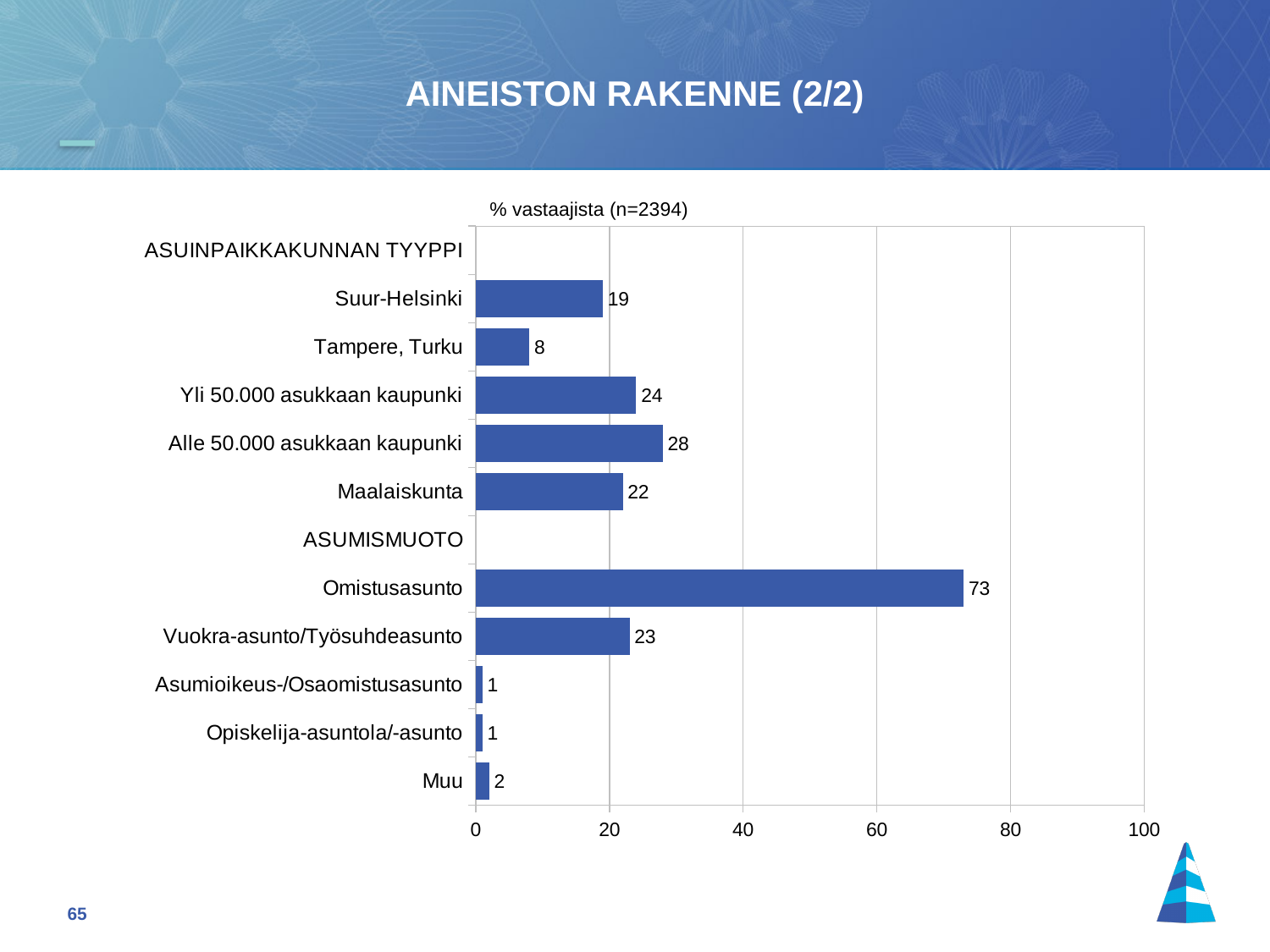
How many bars with values are plotted in the chart? 10 What kind of chart is shown on the slide? bar chart Is the value for Omistusasunto greater or less than 60? greater What is the value for Suur-Helsinki? 19 What is the value for Muu? 2 Which category has the highest value in the chart? Omistusasunto What is the value for Maalaiskunta? 22 What is the value for Omistusasunto? 73 Among the ASUINPAIKKAKUNNAN TYYPPI categories, which has the lowest value? Tampere, Turku Which is larger, the value for Vuokra-asunto/Työsuhdeasunto or the value for Suur-Helsinki? Vuokra-asunto/Työsuhdeasunto What is the title shown above the chart? % vastaajista (n=2394) What is the difference between the values for Alle 50.000 asukkaan kaupunki and Yli 50.000 asukkaan kaupunki? 4